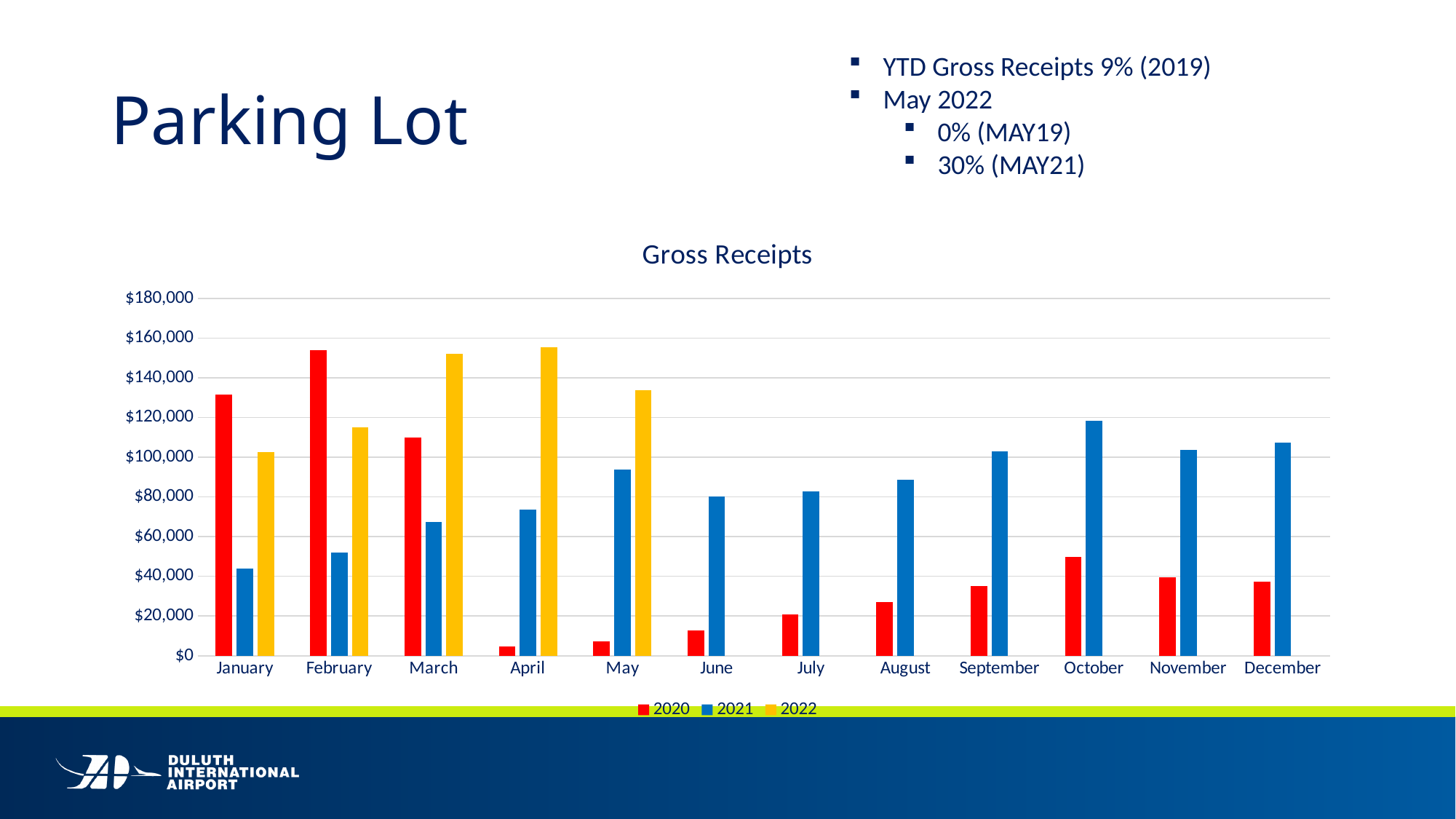
How many months are shown on the x axis? 12 In March, which series is larger: 2021 or 2022? 2022 What kind of chart is shown on the slide? Bar chart Which month has the lowest 2020 gross receipts? April Which month has the lowest 2021 gross receipts? January For how many months does the chart show a 2022 bar? 5 What is the title of the chart? Gross Receipts Is the 2020 value for April greater or less than $20,000? less Which month has the highest 2020 gross receipts? February Is the 2021 value for October greater or less than $100,000? greater How many series does the legend list? 3 Which month has the highest 2021 gross receipts? October